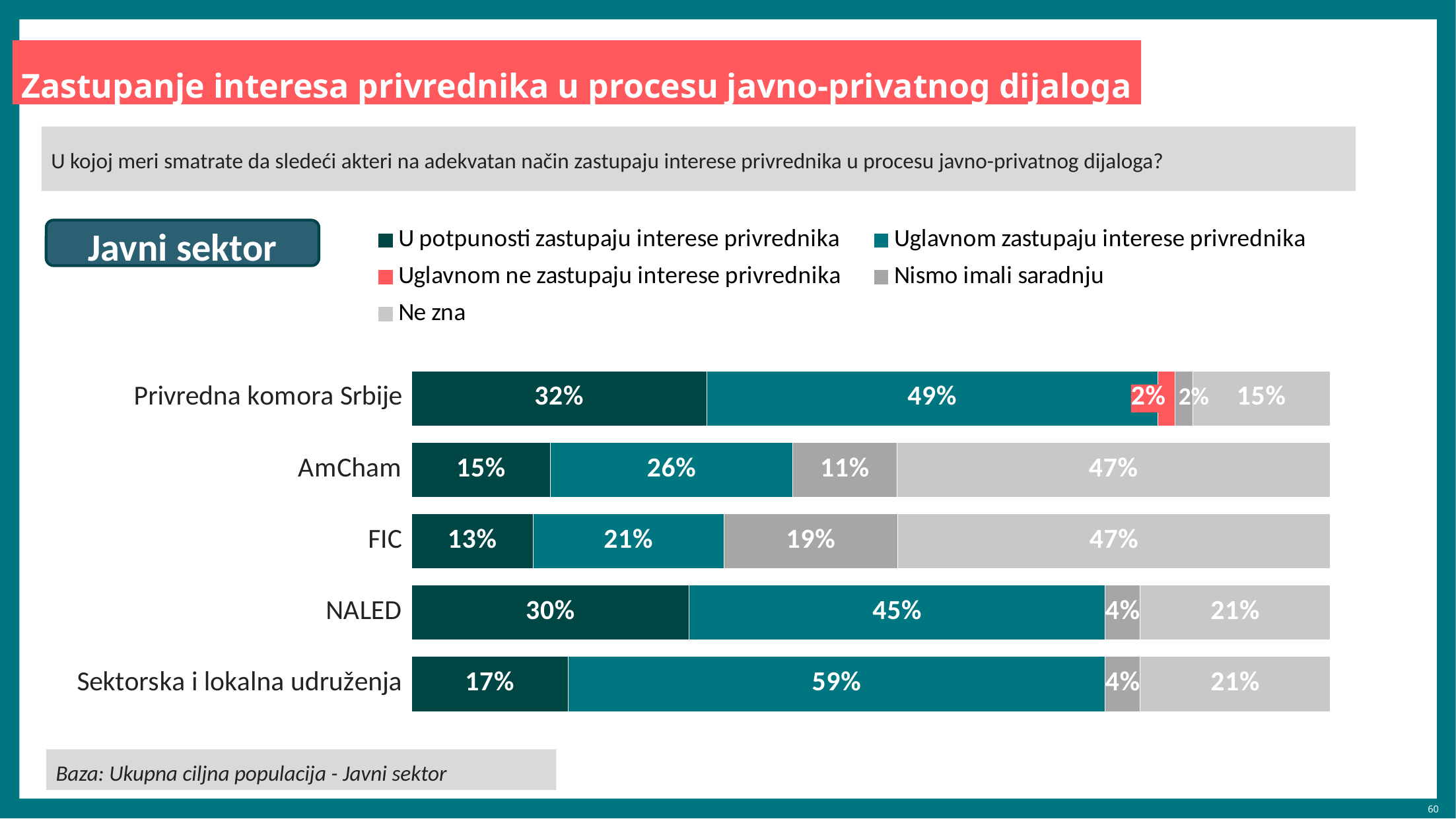
Which actor has the lowest value for 'U potpunosti zastupaju interese privrednika'? FIC Which actor has the highest value for 'U potpunosti zastupaju interese privrednika'? Privredna komora Srbije What is the 'Ne zna' value for AmCham? 47% What is the value of 'Uglavnom zastupaju interese privrednika' for Sektorska i lokalna udruženja? 59% What is the 'Nismo imali saradnju' value for FIC? 19% Which actor is the only one with a value shown for 'Uglavnom ne zastupaju interese privrednika'? Privredna komora Srbije What kind of chart is shown on the slide? stacked bar chart How many categories (actors) are shown on the chart? 5 What is the value of 'U potpunosti zastupaju interese privrednika' for Privredna komora Srbije? 32% How many series does the legend list? 5 What is the difference between the 'Uglavnom zastupaju interese privrednika' values for NALED and AmCham? 19% Which is larger: the 'Ne zna' value for NALED or for Privredna komora Srbije? NALED